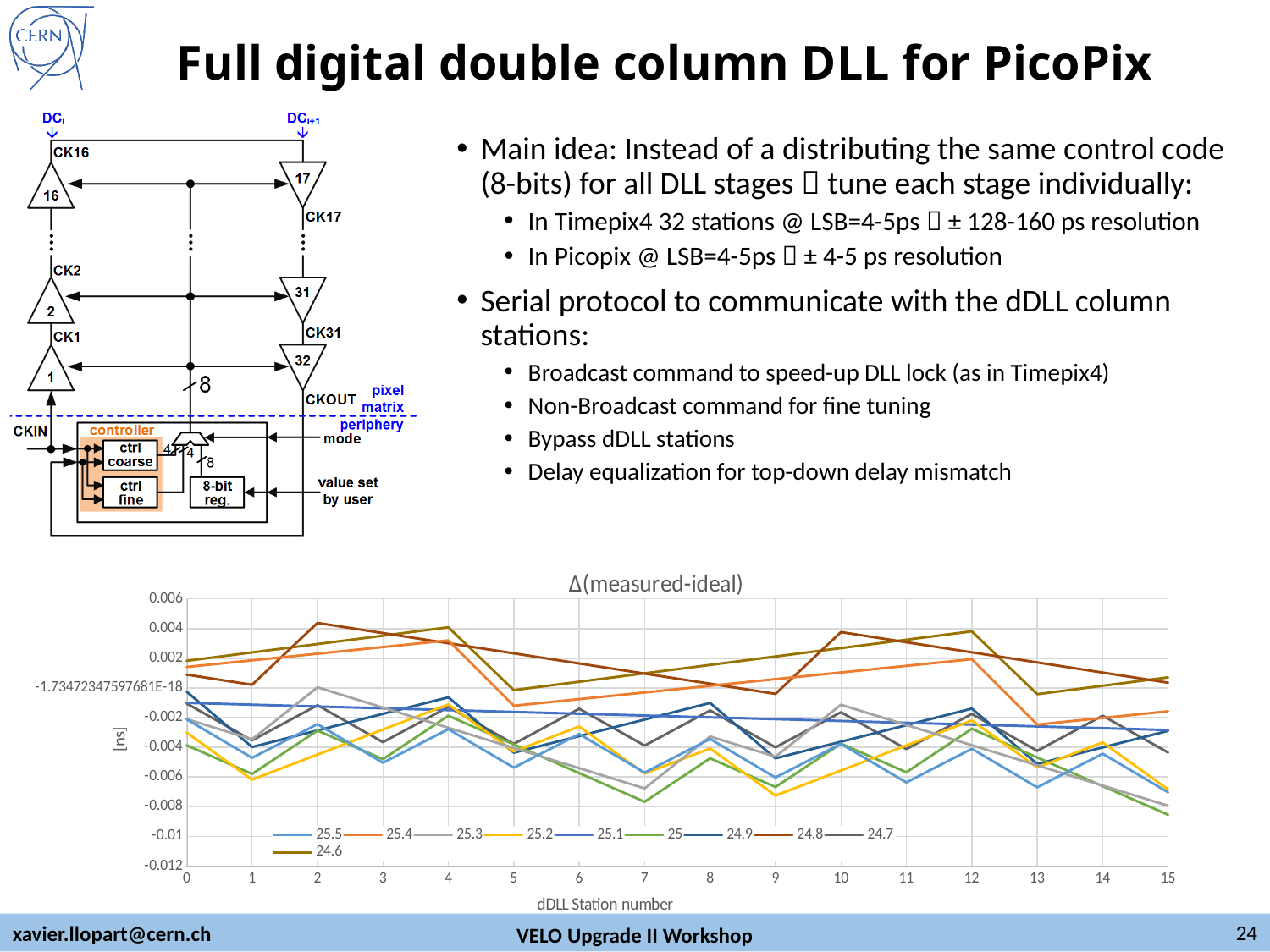
In the Δ(measured-ideal) chart, is the value of series 25.3 at station 15 greater or less than -0.006? less In the Δ(measured-ideal) chart, is the value of series 25 at station 15 greater or less than -0.006? less What is the title of the chart at the bottom of the slide? Δ(measured-ideal) In the Δ(measured-ideal) chart, is the value of series 25.4 at station 4 greater or less than 0.002? greater What kind of chart is shown at the bottom of the slide? line chart What is the x-axis label of the Δ(measured-ideal) chart? dDLL Station number How many series does the legend of the Δ(measured-ideal) chart list? 10 How many dDLL station numbers are shown along the x axis of the Δ(measured-ideal) chart? 16